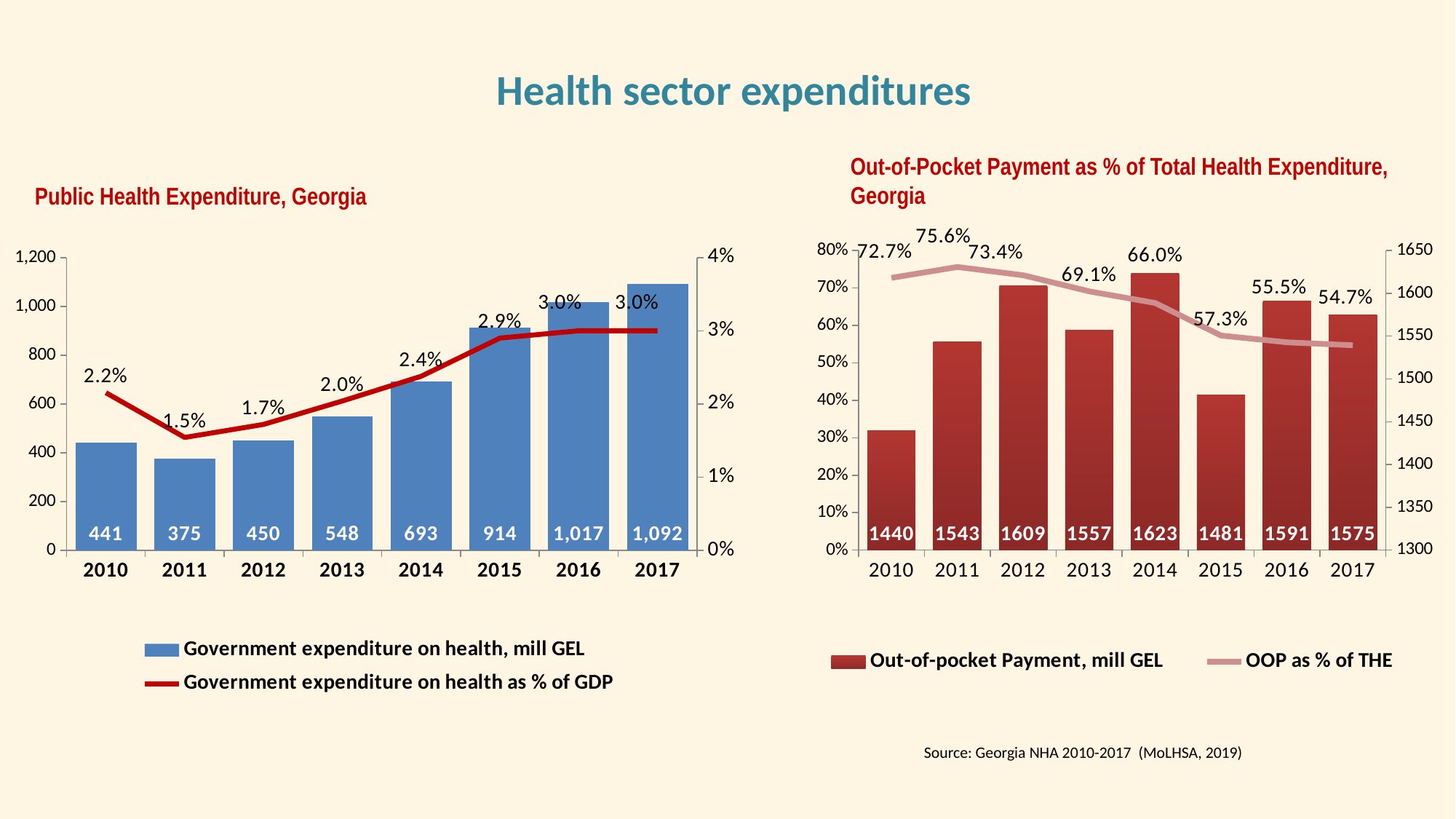
In the 'Public Health Expenditure, Georgia' chart, which year has the highest government expenditure on health in mill GEL? 2017 In the 'Out-of-Pocket Payment as % of Total Health Expenditure, Georgia' chart, which year has the highest out-of-pocket payment in mill GEL? 2014 In the 'Public Health Expenditure, Georgia' chart, what was government expenditure on health as % of GDP in 2011? 1.5% In the 'Out-of-Pocket Payment as % of Total Health Expenditure, Georgia' chart, which year has the lowest OOP as % of THE? 2017 In the 'Out-of-Pocket Payment as % of Total Health Expenditure, Georgia' chart, how many years are shown on the x axis? 8 In the 'Public Health Expenditure, Georgia' chart, what is the difference in government expenditure on health (mill GEL) between 2017 and 2016? 75 In the 'Public Health Expenditure, Georgia' chart, what was government expenditure on health in mill GEL in 2014? 693 In the 'Out-of-Pocket Payment as % of Total Health Expenditure, Georgia' chart, is out-of-pocket payment in mill GEL larger in 2011 or 2013? 2013 In the 'Out-of-Pocket Payment as % of Total Health Expenditure, Georgia' chart, what was out-of-pocket payment in mill GEL in 2012? 1609 In the 'Public Health Expenditure, Georgia' chart, which year has the lowest government expenditure on health in mill GEL? 2011 In the 'Public Health Expenditure, Georgia' chart, how many series does the legend list? 2 In the 'Out-of-Pocket Payment as % of Total Health Expenditure, Georgia' chart, what was OOP as % of THE in 2015? 57.3%